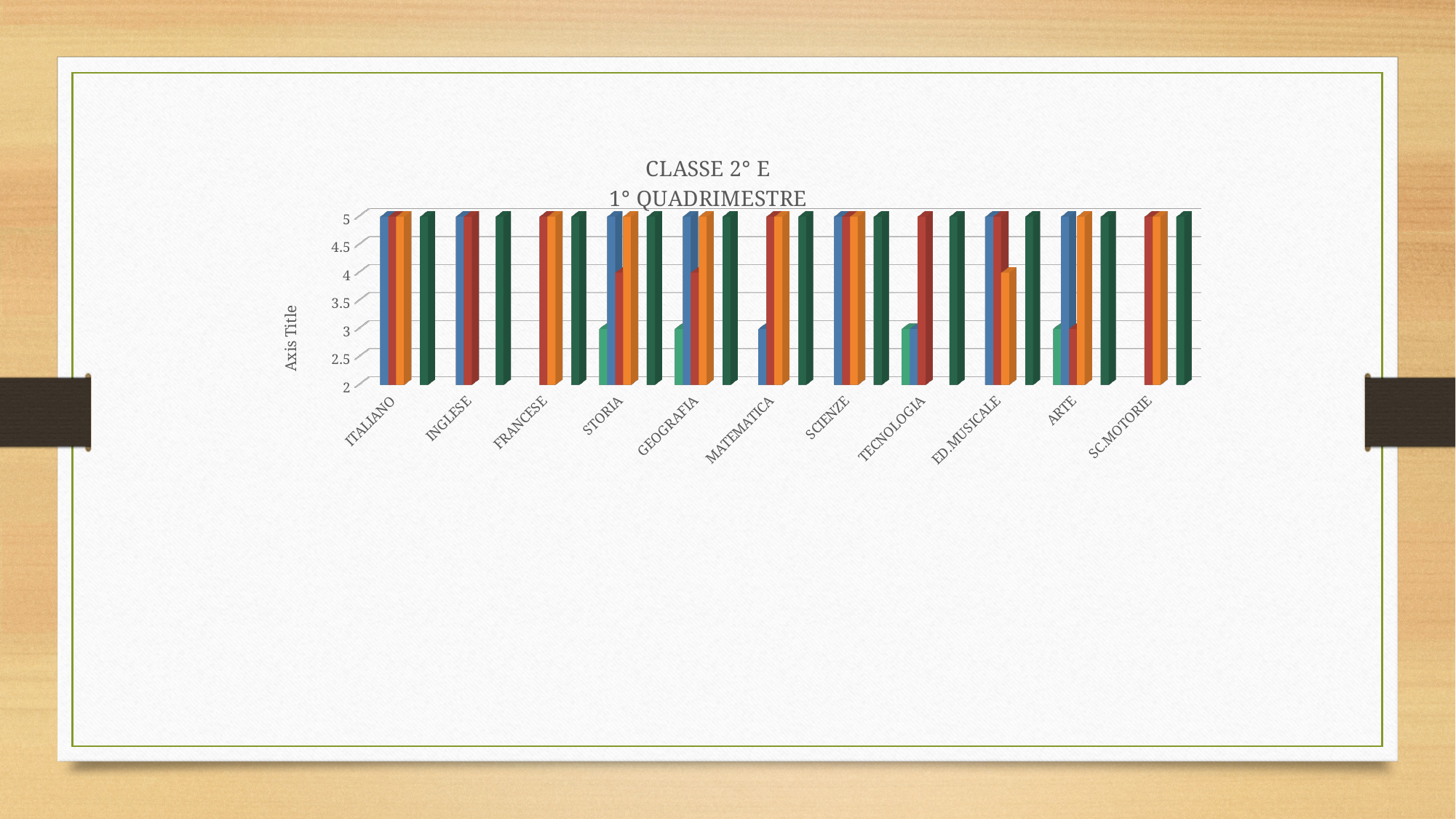
What value does the orange bar for ED.MUSICALE reach? 4 What is the highest value shown on the vertical axis of the chart? 5 For STORIA, which is taller: the blue bar or the light green bar? the blue bar What kind of chart is shown on the slide? bar chart How many subject categories are shown on the x axis of the chart? 11 Is the orange bar for ED.MUSICALE greater or less than 4.5? less Which category is listed last on the x axis of the chart? SC.MOTORIE What value does the light green bar for STORIA reach? 3 What is the title of the chart? CLASSE 2° E 1° QUADRIMESTRE What is the label on the vertical axis of the chart? Axis Title What is the lowest value shown on the vertical axis of the chart? 2 Which category is listed first on the x axis of the chart? ITALIANO